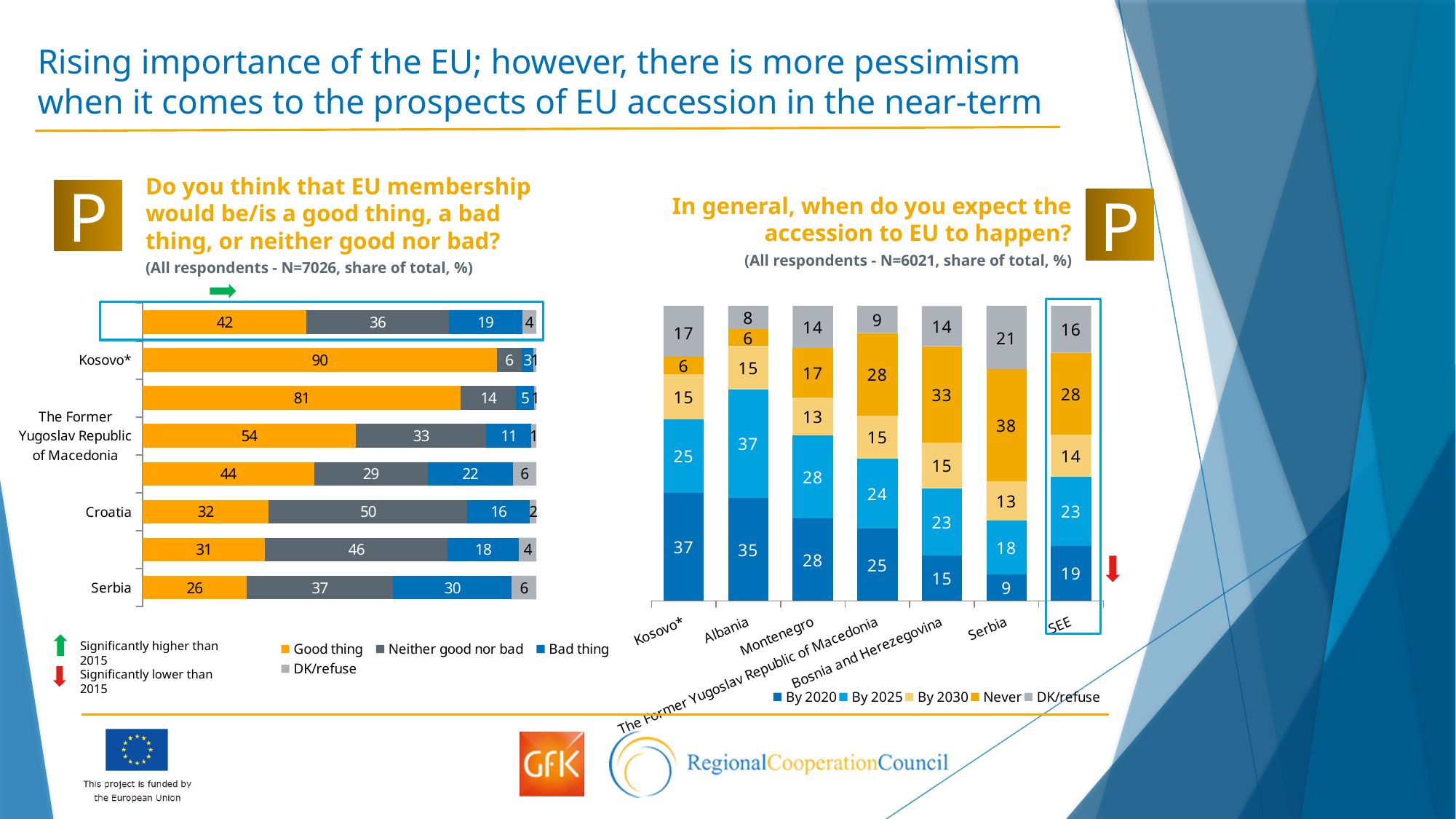
In the right chart (when do you expect the accession to EU to happen), which is larger: the 'By 2020' share for Kosovo* or for Serbia? Kosovo* In the left chart (EU membership good/bad thing), what is the difference between the 'Good thing' share for Kosovo* and for Serbia? 64 How many countries/regions are shown on the x axis of the right chart (when do you expect the accession to EU to happen)? 7 In the right chart (when do you expect the accession to EU to happen), which country has the lowest share for 'By 2020'? Serbia In the left chart (EU membership good/bad thing), which country has the highest share for 'Good thing'? Kosovo* In the right chart (when do you expect the accession to EU to happen), what share of respondents in Serbia answered 'Never'? 38 In the left chart (EU membership good/bad thing), what share of respondents in Kosovo* said EU membership is a good thing? 90 In the left chart (EU membership good/bad thing), what share of respondents in Croatia said 'Neither good nor bad'? 50 How many series does the legend of the left chart (EU membership good/bad thing) list? 4 What type of chart is the right chart (when do you expect the accession to EU to happen)? Stacked bar chart In the right chart (when do you expect the accession to EU to happen), what share of respondents in Albania answered 'By 2025'? 37 In the left chart (EU membership good/bad thing), what share of respondents in Serbia said EU membership is a bad thing? 30